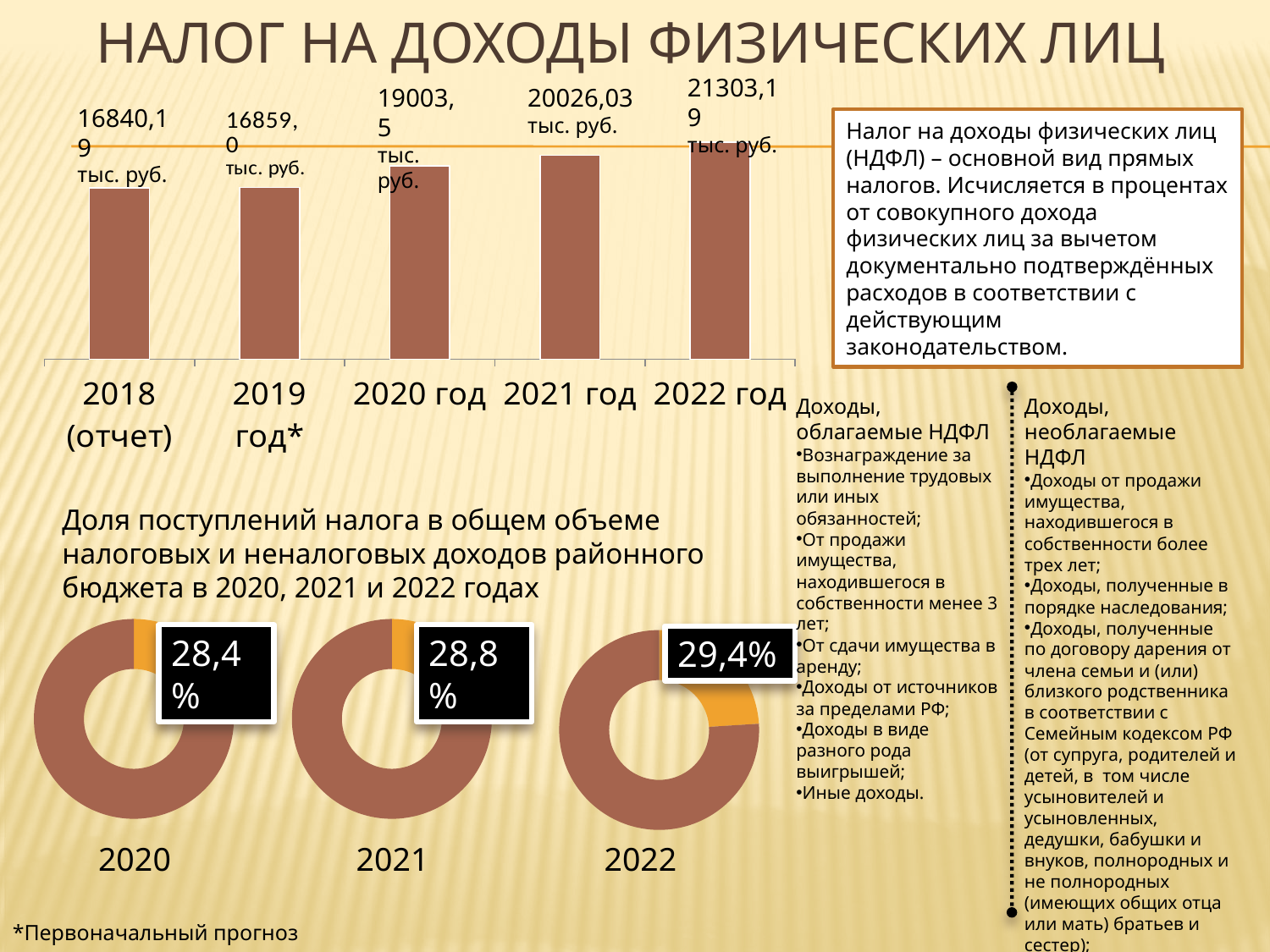
In the bar chart, do the values rise or fall from 2018 to 2022? rise In the bar chart, which is larger: the value for 2021 год or the value for 2020 год? 2021 год In the bar chart, which year has the highest value? 2022 год In the bar chart, what is the value for 2018 (отчет)? 16840,19 тыс. руб. In the donut chart for 2021, what share of the district budget revenue does the tax account for? 28,8% In the bar chart, what is the value for 2020 год? 19003,5 тыс. руб. How many bars are in the bar chart? 5 What kind of chart is the chart at the top left of the slide? bar chart In the bar chart, what is the value for 2022 год? 21303,19 тыс. руб. Among the three donut charts (2020, 2021, 2022), which year shows the highest share? 2022 In the bar chart, what is the difference between the values for 2022 год and 2018 (отчет)? 4463,00 тыс. руб. In the bar chart, which year has the lowest value? 2018 (отчет)